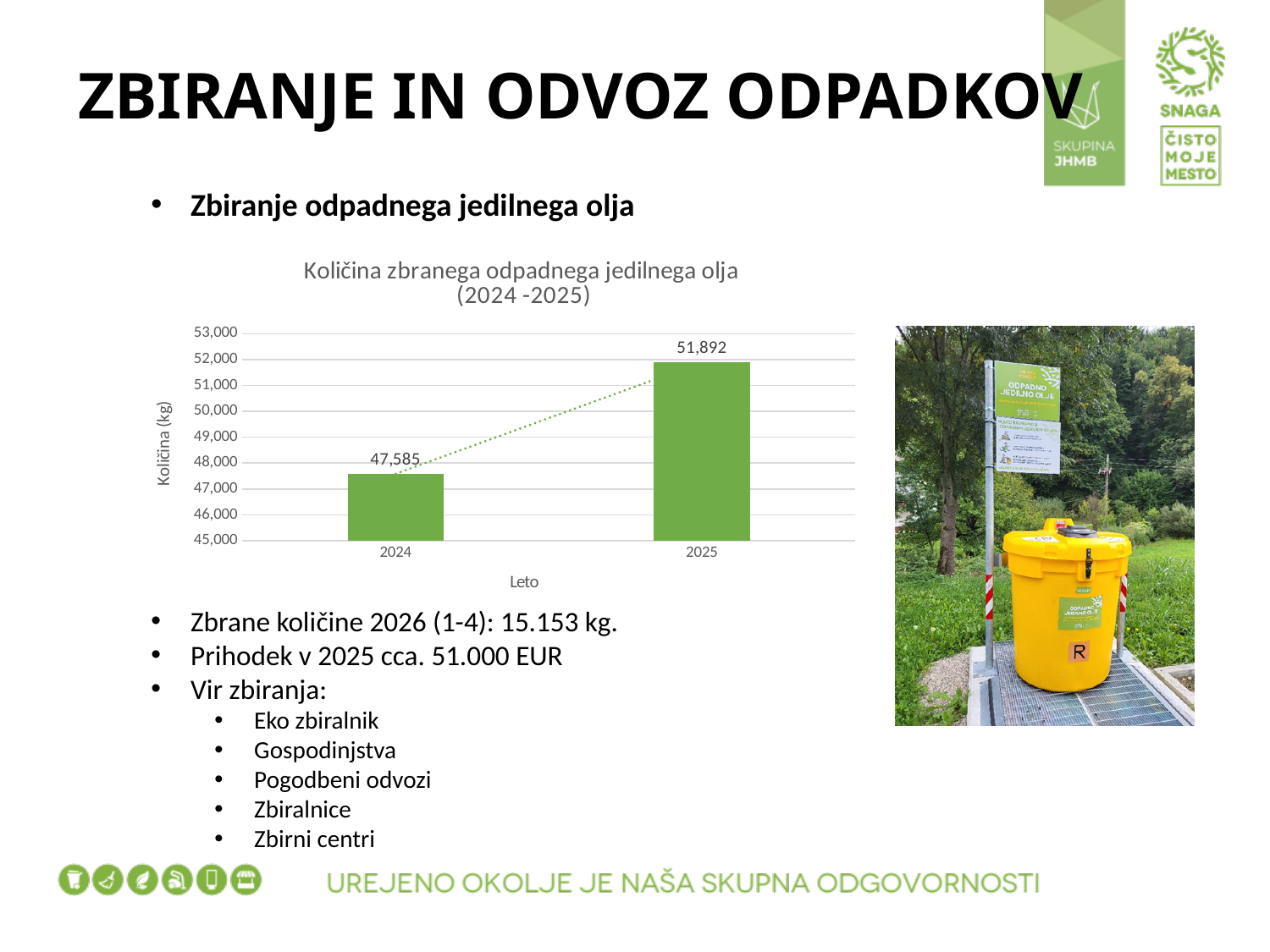
How many years are shown in the chart? 2 Which year has the highest value in the chart? 2025 What is the title of the chart? Količina zbranega odpadnega jedilnega olja (2024 -2025) What is the value for 2025 in the chart? 51,892 Do the values rise or fall from 2024 to 2025? rise Is the value for 2024 greater or less than 48,000? less Which is larger in the chart, the value for 2024 or the value for 2025? 2025 What is the value for 2024 in the chart? 47,585 What kind of chart is shown on the slide? bar chart What is the difference between the 2025 and 2024 values in the chart? 4,307 Which year has the lowest value in the chart? 2024 Is the value for 2025 greater or less than 51,000? greater